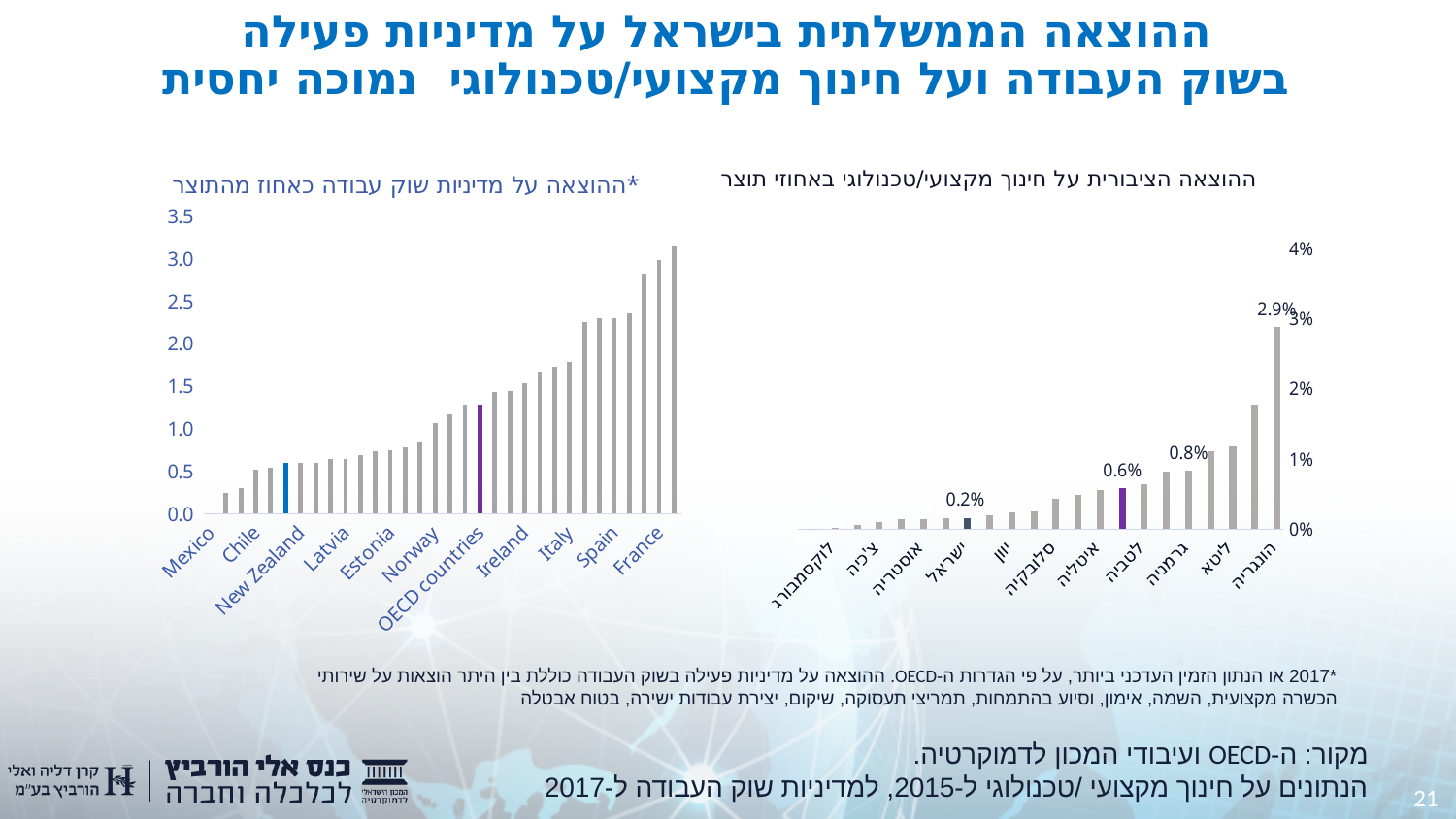
What kind of chart is the right chart (ההוצאה הציבורית על חינוך מקצועי/טכנולוגי באחוזי תוצר)? bar chart In the right chart (ההוצאה הציבורית על חינוך מקצועי/טכנולוגי באחוזי תוצר), what is the difference between the values for הונגריה and ישראל? 2.7% In the right chart (ההוצאה הציבורית על חינוך מקצועי/טכנולוגי באחוזי תוצר), which is larger, the value for ישראל or the value for הונגריה? הונגריה In the left chart (ההוצאה על מדיניות שוק עבודה כאחוז מהתוצר), do the values rise or fall from left to right along the x axis? rise In the left chart (ההוצאה על מדיניות שוק עבודה כאחוז מהתוצר), is the value for Mexico greater or less than 0.5? less In the left chart (ההוצאה על מדיניות שוק עבודה כאחוז מהתוצר), which country has the lowest value? Mexico In the right chart (ההוצאה הציבורית על חינוך מקצועי/טכנולוגי באחוזי תוצר), what is the value for ישראל? 0.2% In the right chart (ההוצאה הציבורית על חינוך מקצועי/טכנולוגי באחוזי תוצר), which country has the lowest value? לוקסמבורג In the left chart (ההוצאה על מדיניות שוק עבודה כאחוז מהתוצר), is the value for OECD countries greater or less than 1.0? greater In the right chart (ההוצאה הציבורית על חינוך מקצועי/טכנולוגי באחוזי תוצר), what is the value for הונגריה? 2.9% In the right chart (ההוצאה הציבורית על חינוך מקצועי/טכנולוגי באחוזי תוצר), which country has the highest value? הונגריה